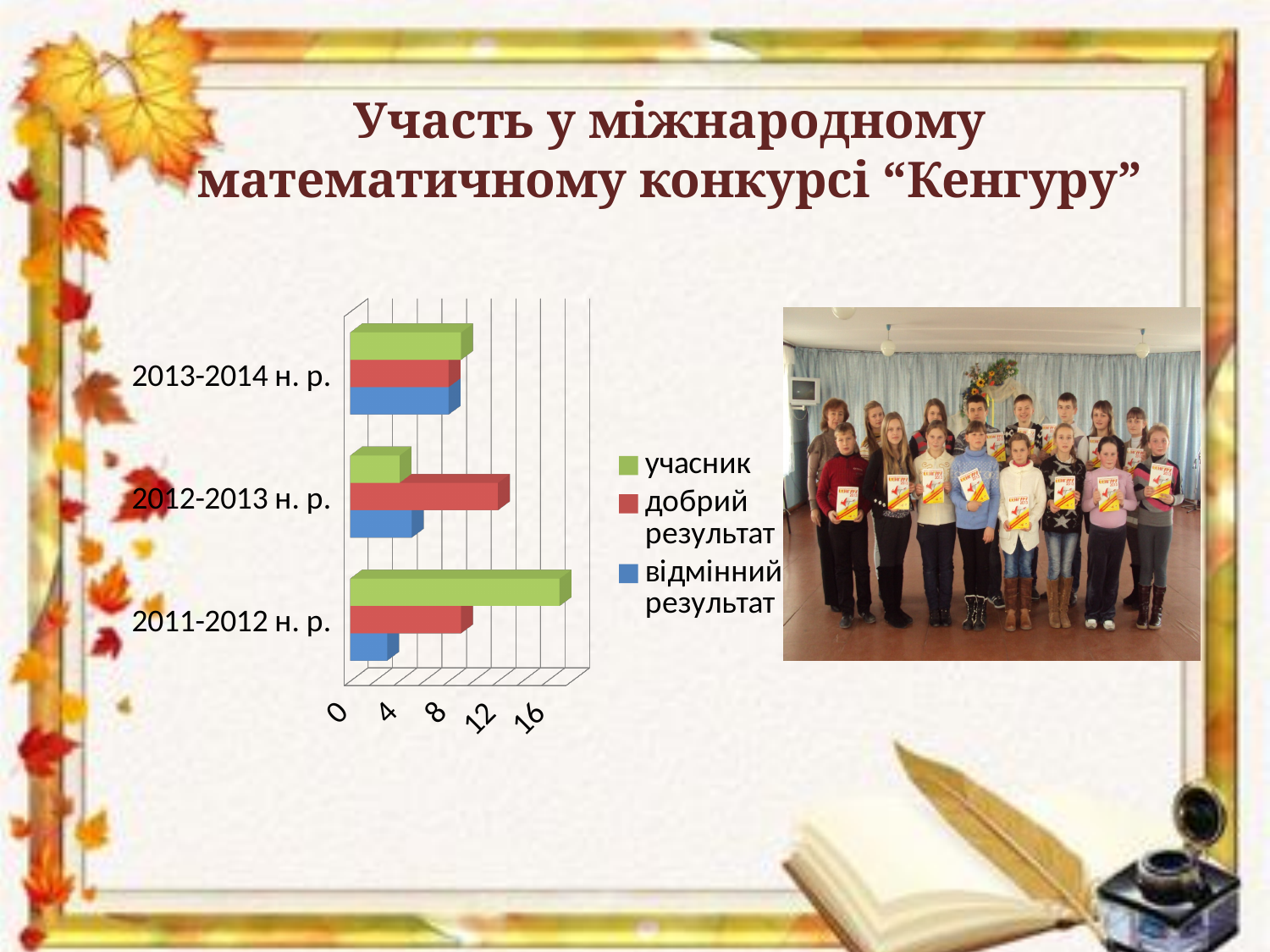
How many school years (categories) does the chart show? 3 Which school year has the highest value for учасник? 2011-2012 н. р. Is the value for відмінний результат in 2012-2013 н. р. greater or less than 8? less Which series is shown in green in the chart legend? учасник Which school year has the lowest value for учасник? 2012-2013 н. р. Which is larger: добрий результат in 2012-2013 н. р. or добрий результат in 2011-2012 н. р.? 2012-2013 н. р. Is the value for добрий результат in 2012-2013 н. р. greater or less than 8? greater Is the value for учасник in 2012-2013 н. р. greater or less than 8? less What kind of chart is shown on the slide? bar chart How many series does the chart legend list? 3 Which is larger: учасник in 2011-2012 н. р. or учасник in 2013-2014 н. р.? 2011-2012 н. р.